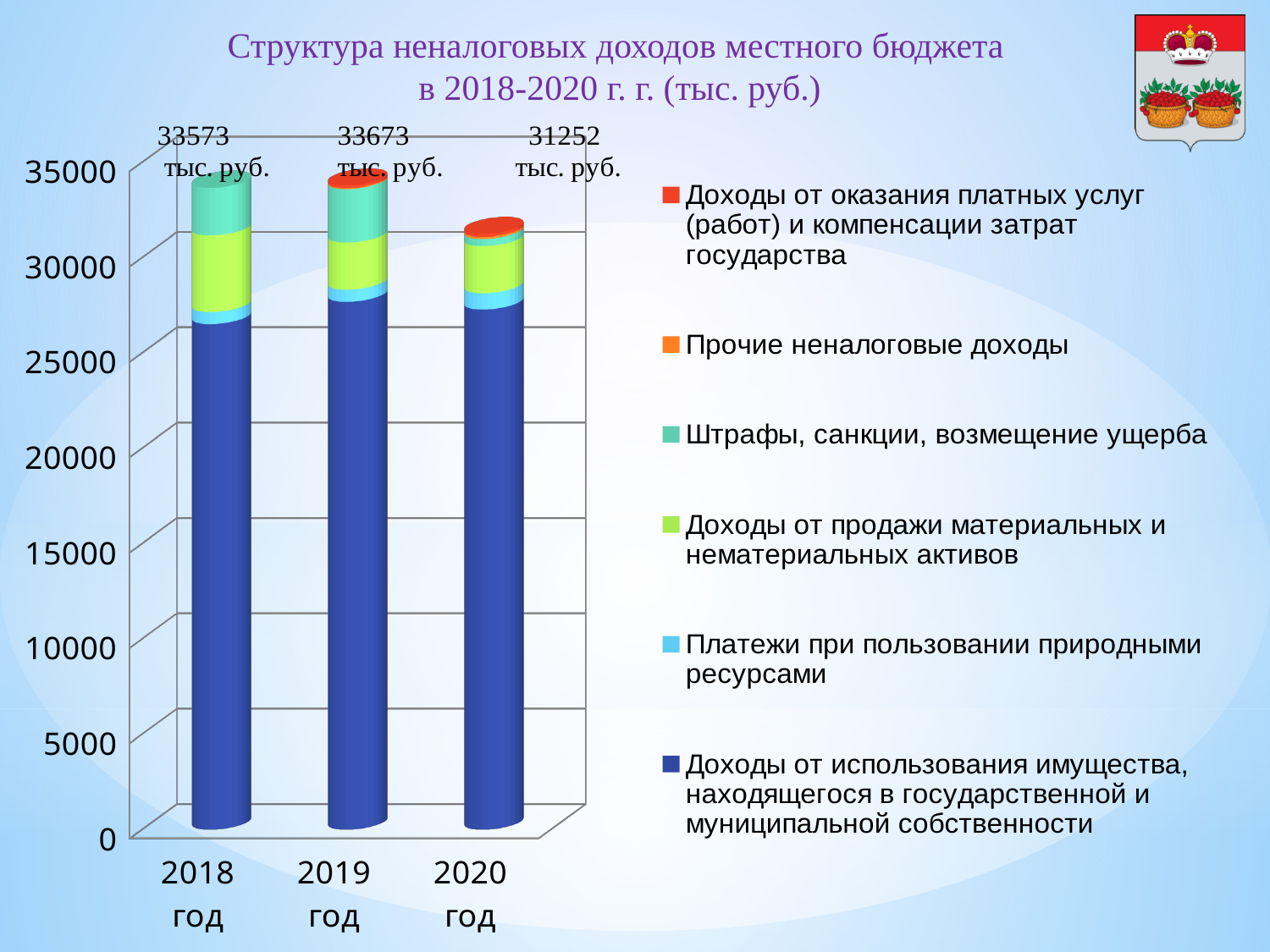
What kind of chart is shown on the slide? Stacked bar chart Is the value of the dark blue segment (Доходы от использования имущества) for 2018 год greater or less than 30000? less What is the total non-tax revenue shown above the bar for 2020 год? 31252 тыс. руб. What is the total non-tax revenue shown above the bar for 2019 год? 33673 тыс. руб. Which total is larger: 2018 год or 2020 год? 2018 год How many series does the legend list? 6 By how much does the total for 2019 год exceed the total for 2018 год (in тыс. руб.)? 100 By how much is the total for 2020 год lower than the total for 2019 год (in тыс. руб.)? 2421 What is the total non-tax revenue shown above the bar for 2018 год? 33573 тыс. руб. Which year has the highest total non-tax revenue according to the labels above the bars? 2019 год Which year has the lowest total non-tax revenue according to the labels above the bars? 2020 год How many years (bars) are shown on the chart? 3